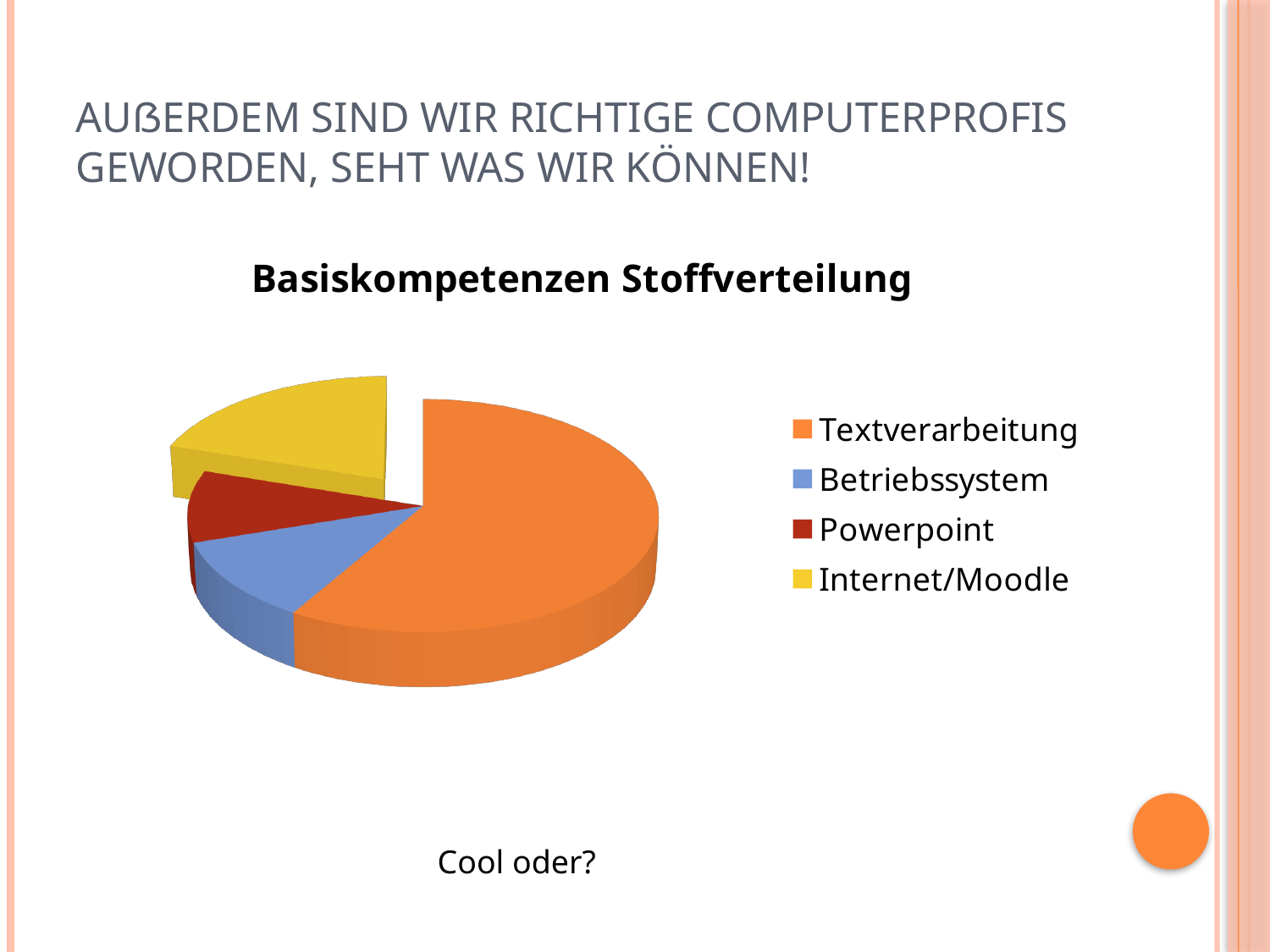
Which slice is larger, Textverarbeitung or Internet/Moodle? Textverarbeitung Does the Textverarbeitung slice make up more or less than half of the pie? more Which colour represents Internet/Moodle in the pie chart? yellow Which category has the largest slice of the pie? Textverarbeitung How many slices does the pie chart have? 4 What is the title of the chart? Basiskompetenzen Stoffverteilung Which slice is larger, Textverarbeitung or Betriebssystem? Textverarbeitung Which slice is larger, Textverarbeitung or Powerpoint? Textverarbeitung How many entries does the legend list? 4 What kind of chart is shown on the slide? pie chart